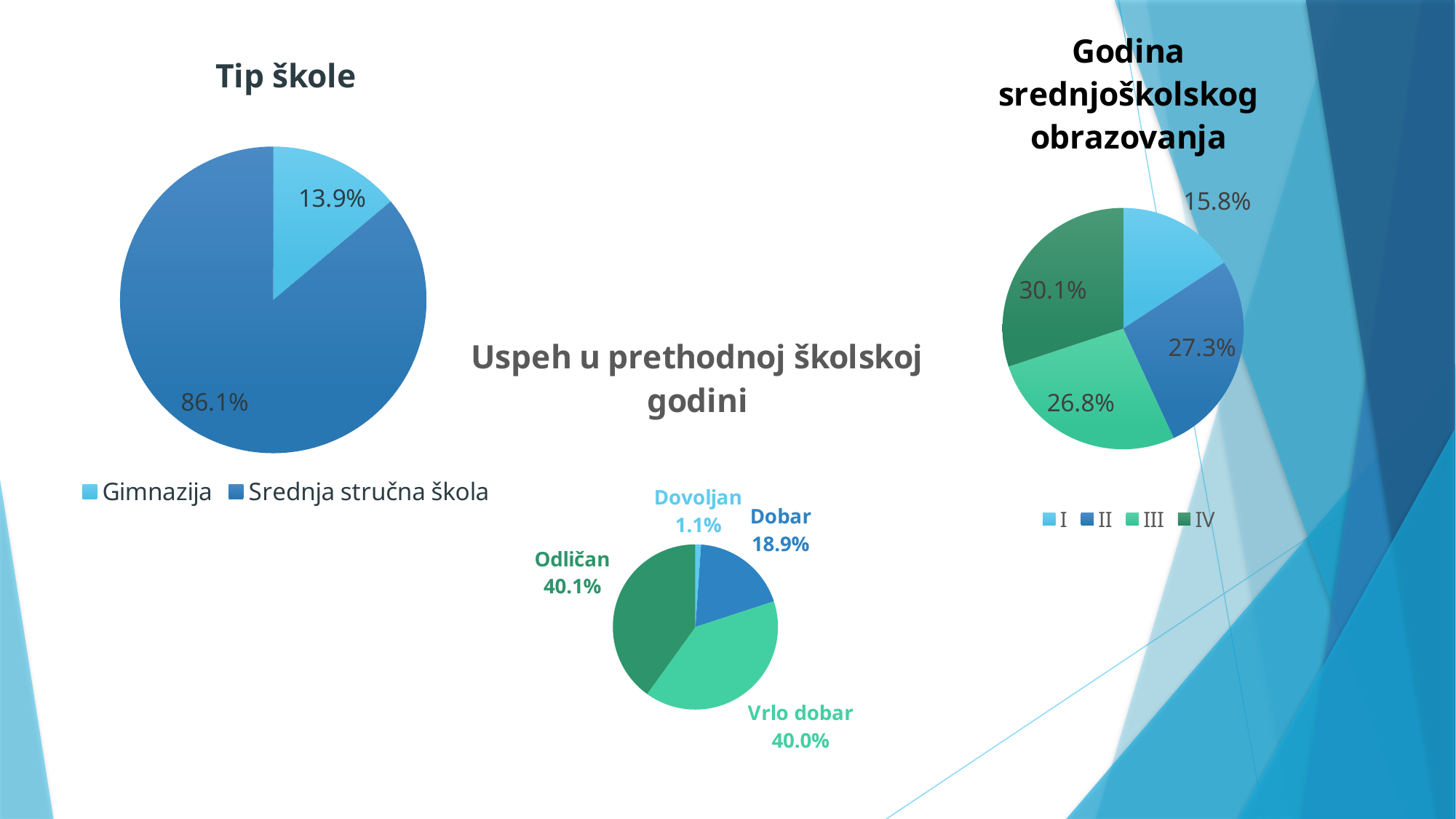
In the 'Godina srednjoškolskog obrazovanja' chart, which year has the largest share? IV What kind of chart is 'Tip škole'? Pie chart In the 'Godina srednjoškolskog obrazovanja' chart, what share is year II? 27.3% In the 'Uspeh u prethodnoj školskoj godini' chart, which is larger, Dobar or Vrlo dobar? Vrlo dobar In the 'Tip škole' chart, what share is Gimnazija? 13.9% In the 'Tip škole' chart, what is the difference between the Srednja stručna škola and Gimnazija shares? 72.2% How many categories are shown in the 'Uspeh u prethodnoj školskoj godini' chart? 4 In the 'Uspeh u prethodnoj školskoj godini' chart, which category has the smallest share? Dovoljan How many entries does the legend of the 'Godina srednjoškolskog obrazovanja' chart list? 4 In the 'Godina srednjoškolskog obrazovanja' chart, which year has the smallest share? I In the 'Uspeh u prethodnoj školskoj godini' chart, what share is Dobar? 18.9% In the 'Tip škole' chart, what share is Srednja stručna škola? 86.1%